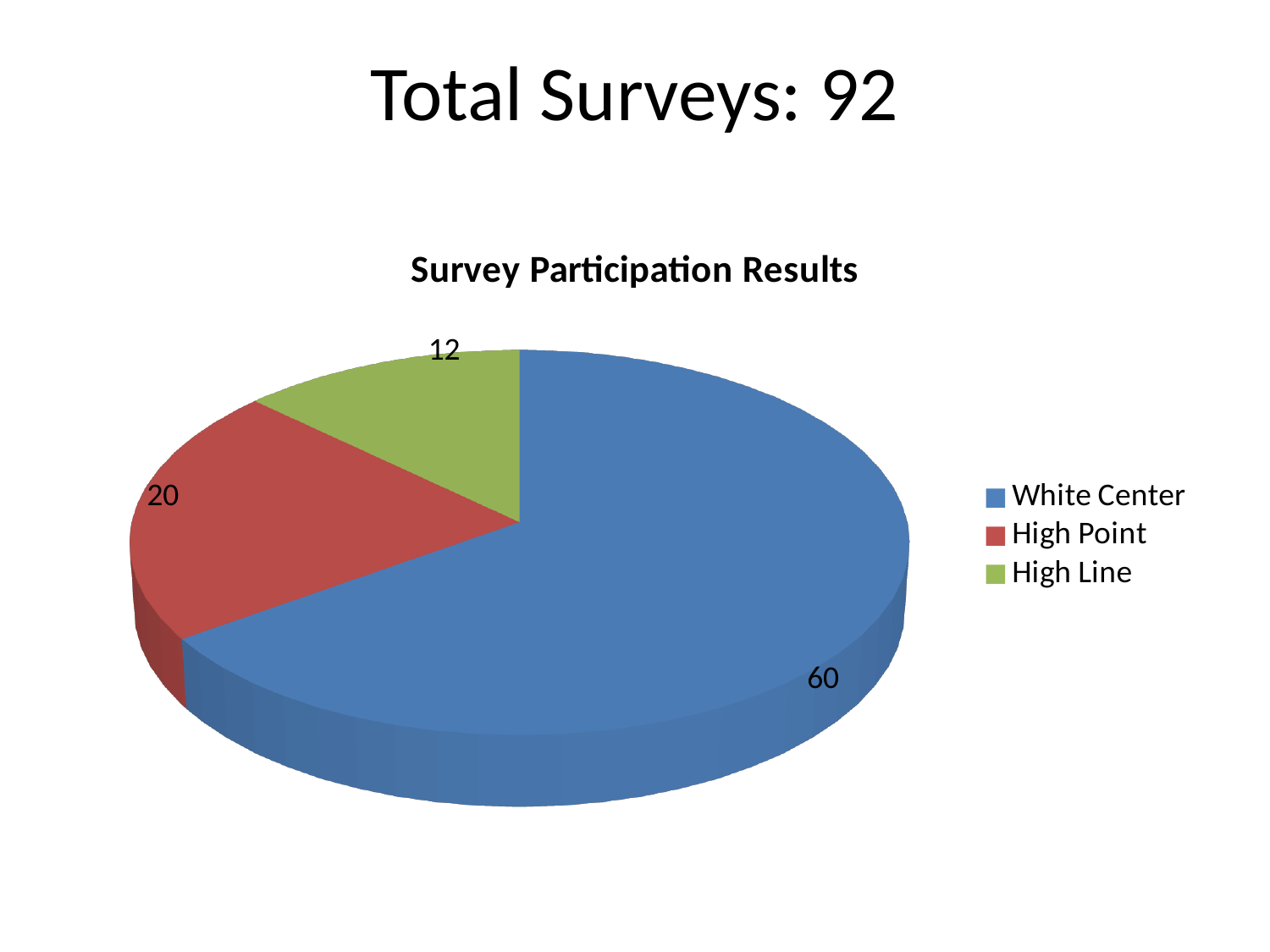
What is the difference between the values for White Center and High Point? 40 Which category has the largest slice? White Center Which category has the smallest slice? High Line Which is larger, the value for High Point or the value for High Line? High Point What is the value for High Point? 20 What is the value for High Line? 12 What is the value for White Center? 60 How many categories does the pie chart show? 3 What colour is the High Line slice? Green What is the title of the chart? Survey Participation Results What is the difference between the values for High Point and High Line? 8 What kind of chart is shown on the slide? Pie chart